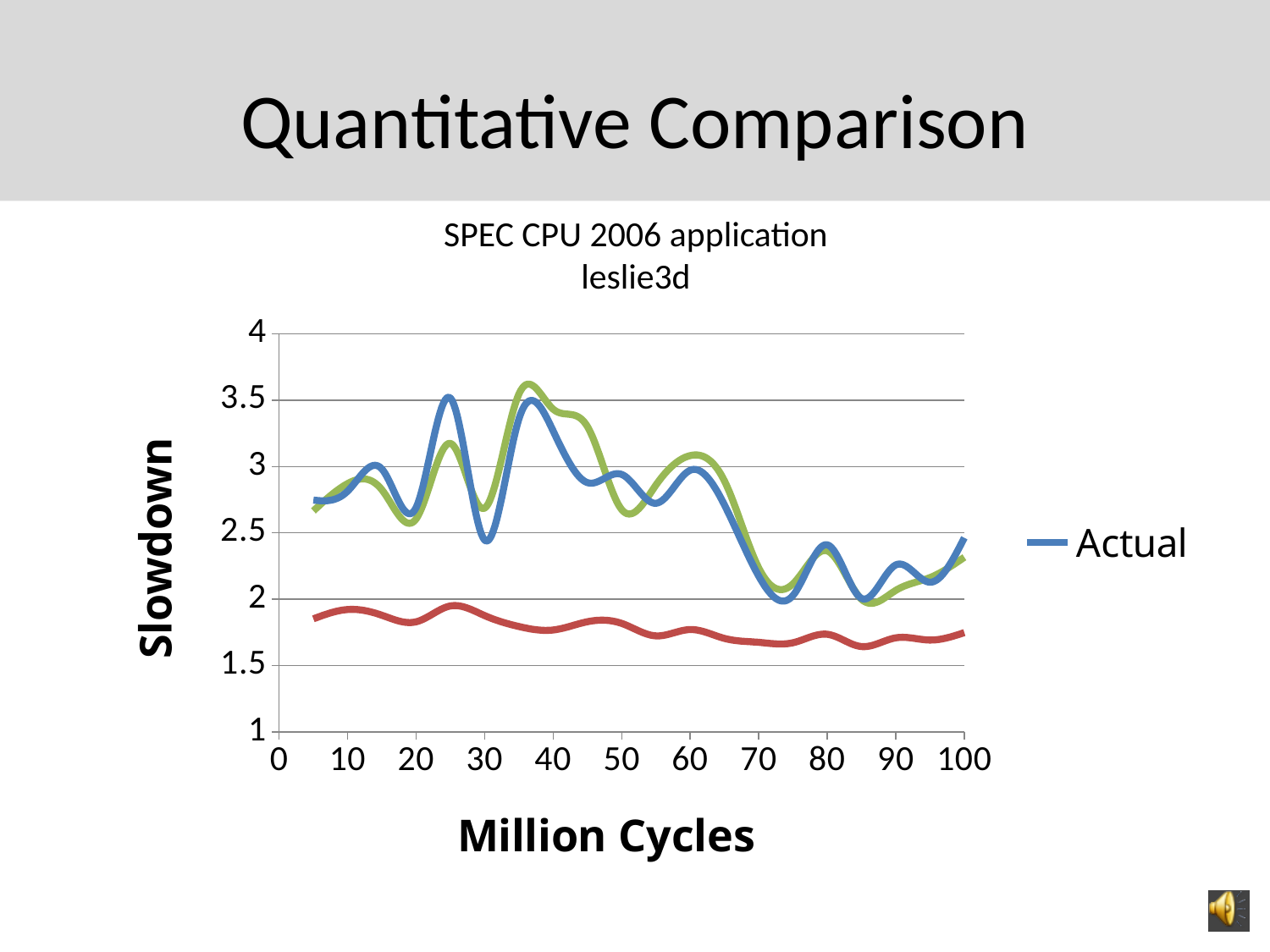
What is the label of the y axis? Slowdown What is the highest value marked on the y axis? 4 What kind of chart is shown on the slide? line chart What is the title of the chart? SPEC CPU 2006 application leslie3d Is the value of the Actual series at 30 million cycles greater or less than 3? less Is the value of the Actual series at 25 million cycles greater or less than 3? greater Between 60 and 75 million cycles, does the Actual line rise or fall? fall Is the value of the Actual series at 40 million cycles greater or less than 3? greater How many series does the legend list? 1 Is the Actual value at 40 million cycles larger or smaller than the Actual value at 80 million cycles? larger